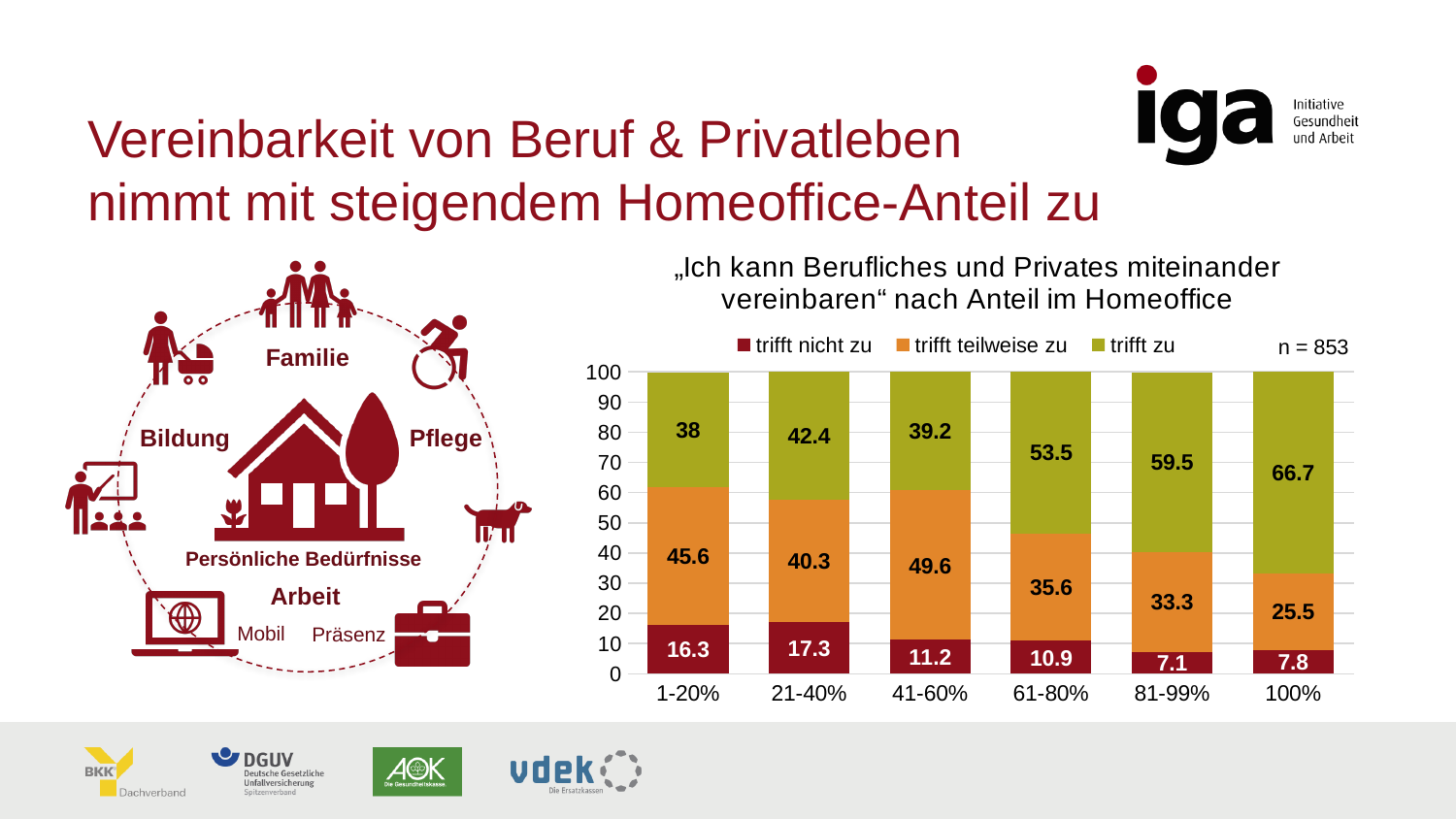
Which category has the highest value for "trifft zu"? 100% What is the value of "trifft nicht zu" for the 21-40% category? 17.3 What kind of chart is shown? Stacked bar chart Which category has the lowest value for "trifft nicht zu"? 81-99% What is the value of "trifft teilweise zu" for the 41-60% category? 49.6 How many series does the legend list? 3 How many categories are shown on the x axis? 6 What is the difference between the "trifft zu" values for 100% and 1-20%? 28.7 What is the value of "trifft zu" for the 100% category? 66.7 What is the total of the stacked bar for the 21-40% category? 100 Which is larger: "trifft teilweise zu" for 1-20% or for 61-80%? 1-20% Does the "trifft zu" value rise or fall from 61-80% to 100% along the x axis? Rise